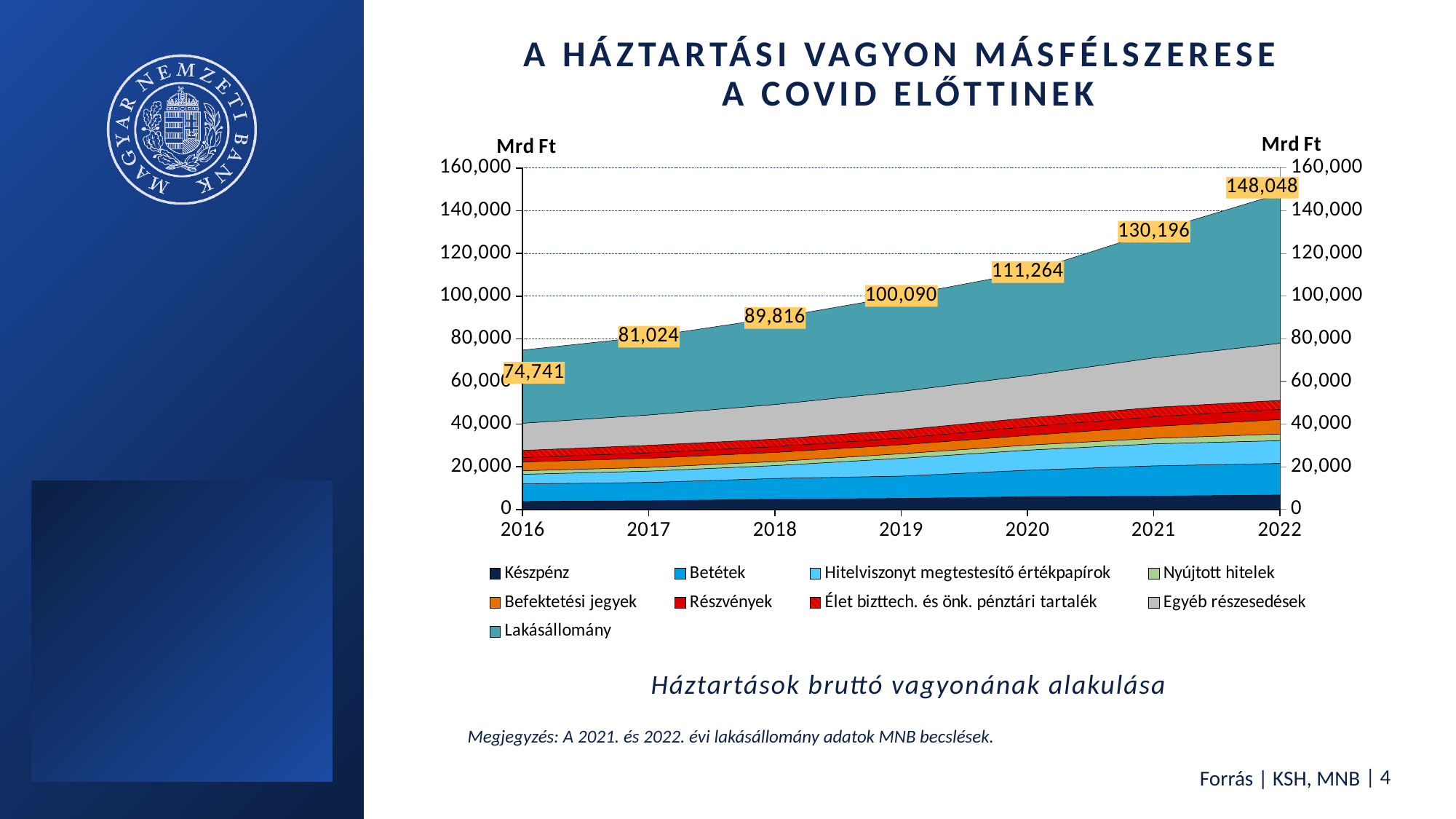
By how much did the total increase from 2016 to 2022? 73,307 Which year has the highest total value? 2022 How many series does the legend list? 9 Do the total values rise or fall from 2016 to 2022? rise How many years are shown on the x axis? 7 Is the total for 2020 greater or less than 100,000? greater What is the total household gross wealth shown for 2022? 148,048 Which year has the lowest total value? 2016 What is the total value labelled for 2016? 74,741 What is the total value labelled for 2019? 100,090 What is the difference between the 2021 and 2020 totals? 18,932 What kind of chart is this? stacked area chart